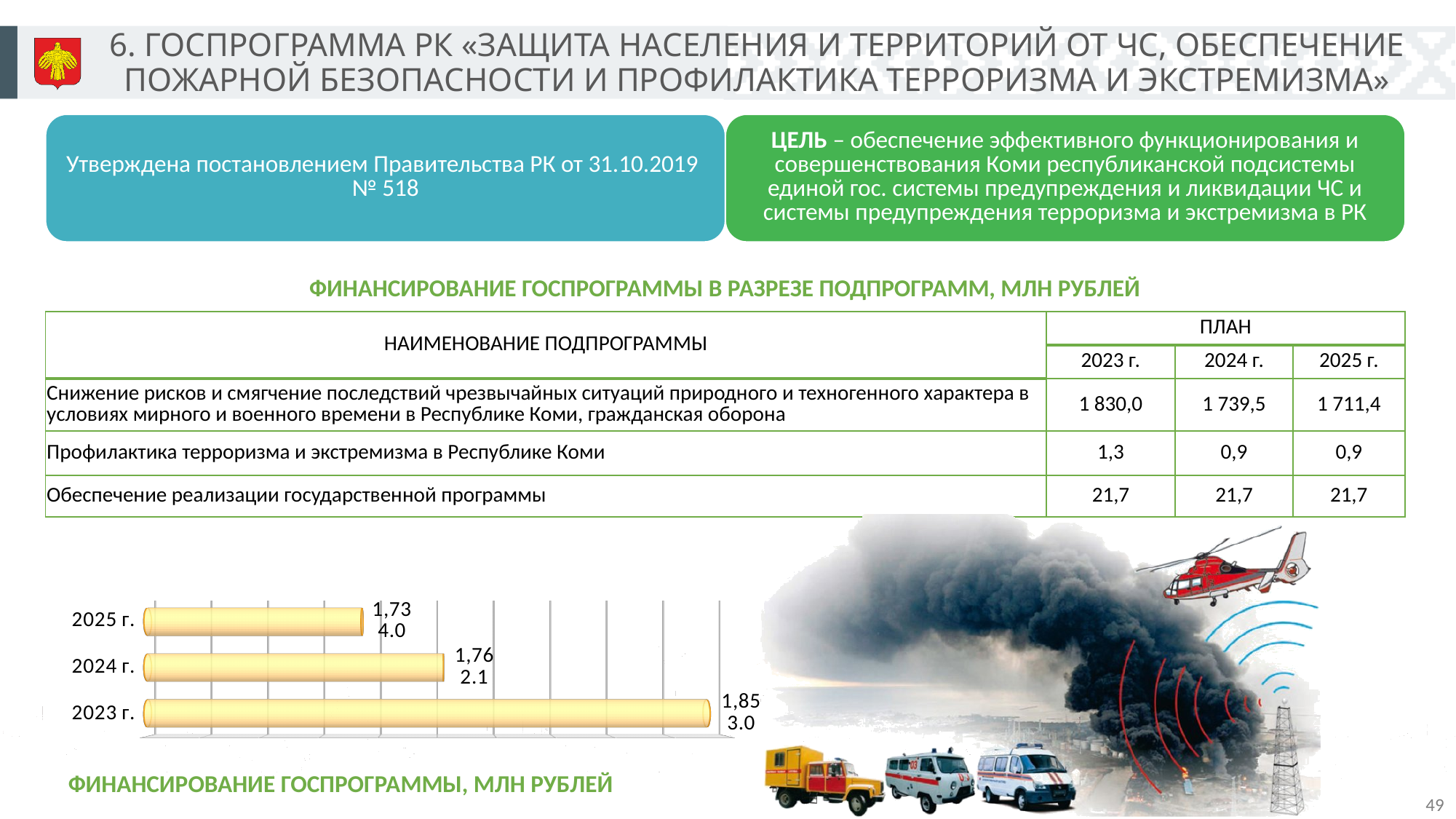
In the bar chart «ФИНАНСИРОВАНИЕ ГОСПРОГРАММЫ, МЛН РУБЛЕЙ», do the values rise or fall from 2023 г. to 2025 г.? Fall In the bar chart «ФИНАНСИРОВАНИЕ ГОСПРОГРАММЫ, МЛН РУБЛЕЙ», which is larger: the value for 2023 г. or the value for 2025 г.? 2023 г. What type of chart is used for «ФИНАНСИРОВАНИЕ ГОСПРОГРАММЫ, МЛН РУБЛЕЙ»? Bar chart In the bar chart «ФИНАНСИРОВАНИЕ ГОСПРОГРАММЫ, МЛН РУБЛЕЙ», what is the difference between the values for 2023 г. and 2025 г.? 119.0 What is the title of the bar chart at the bottom left of the slide? ФИНАНСИРОВАНИЕ ГОСПРОГРАММЫ, МЛН РУБЛЕЙ In the bar chart «ФИНАНСИРОВАНИЕ ГОСПРОГРАММЫ, МЛН РУБЛЕЙ», what is the difference between the values for 2023 г. and 2024 г.? 90.9 How many years (categories) are shown in the bar chart «ФИНАНСИРОВАНИЕ ГОСПРОГРАММЫ, МЛН РУБЛЕЙ»? 3 What is the value for 2025 г. in the bar chart titled «ФИНАНСИРОВАНИЕ ГОСПРОГРАММЫ, МЛН РУБЛЕЙ»? 1,734.0 In the bar chart «ФИНАНСИРОВАНИЕ ГОСПРОГРАММЫ, МЛН РУБЛЕЙ», which year has the highest value? 2023 г. In the bar chart «ФИНАНСИРОВАНИЕ ГОСПРОГРАММЫ, МЛН РУБЛЕЙ», which year has the lowest value? 2025 г. What is the value for 2024 г. in the bar chart titled «ФИНАНСИРОВАНИЕ ГОСПРОГРАММЫ, МЛН РУБЛЕЙ»? 1,762.1 What is the value for 2023 г. in the bar chart titled «ФИНАНСИРОВАНИЕ ГОСПРОГРАММЫ, МЛН РУБЛЕЙ»? 1,853.0